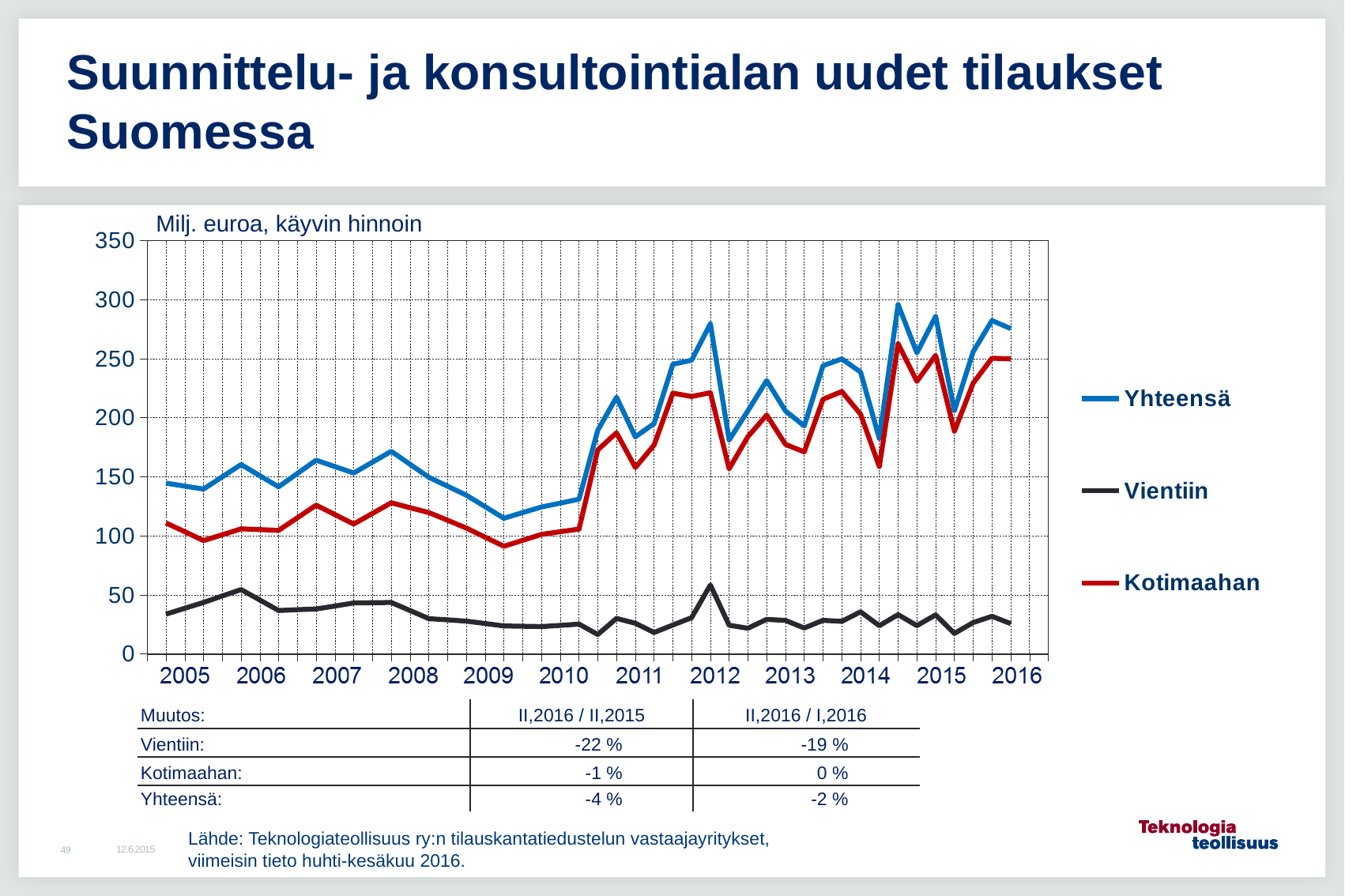
Which series has the highest values throughout the chart? Yhteensä In 2016, which is larger: Kotimaahan or Vientiin? Kotimaahan What unit label is shown above the chart? Milj. euroa, käyvin hinnoin Is the value for Yhteensä in 2009 greater or less than 150? less Is the value for Kotimaahan at the start of 2005 greater or less than 100? greater How many series does the legend list? 3 What are the three series named in the legend? Yhteensä, Vientiin, Kotimaahan Does the Yhteensä series overall rise or fall from 2005 to 2016? rise Is the peak value of Yhteensä in 2014 greater or less than 250? greater What kind of chart is shown on the slide? line chart Which series has the lowest values throughout the chart? Vientiin